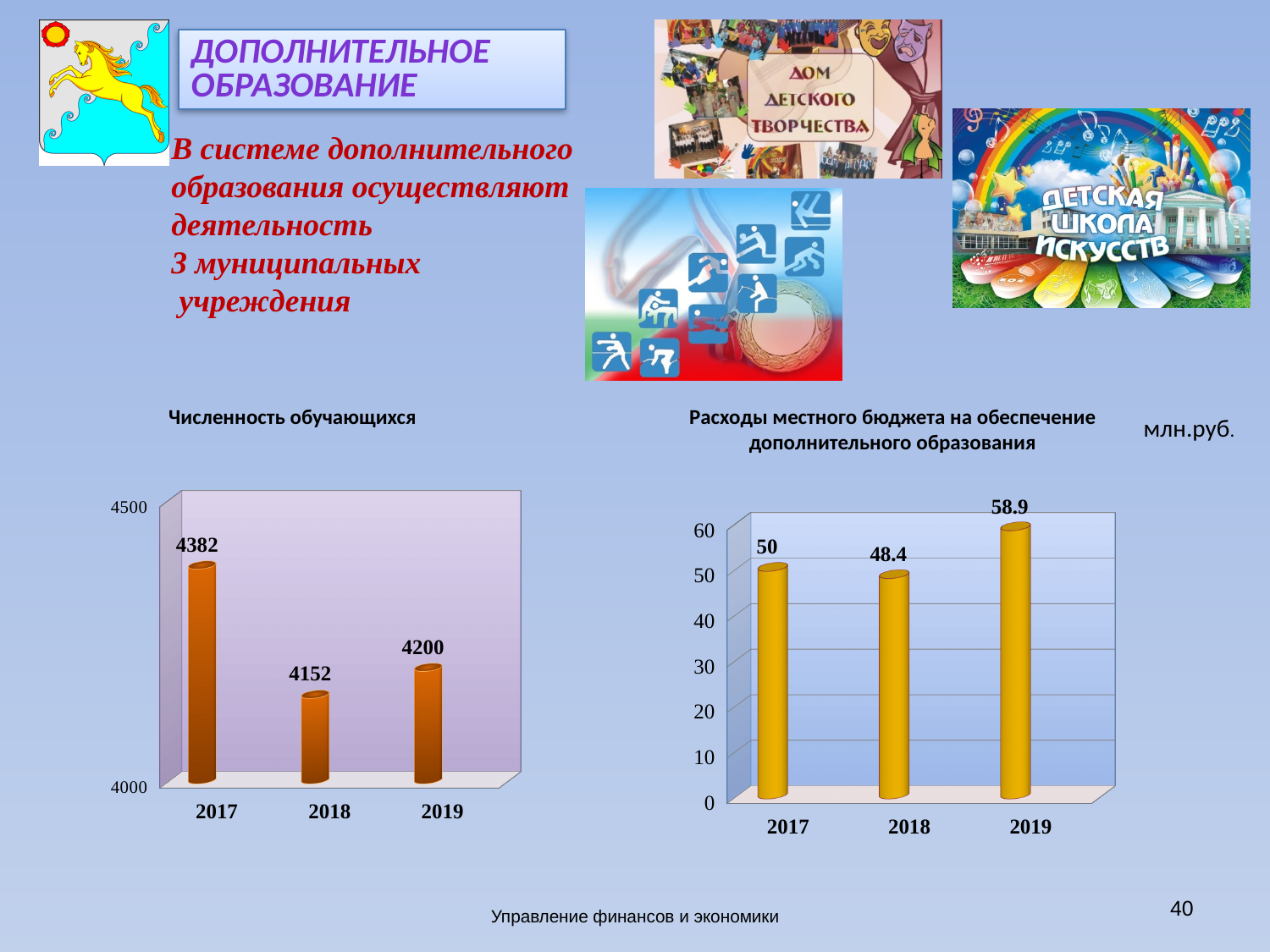
In the 'Расходы местного бюджета на обеспечение дополнительного образования' chart, what is the value for 2018? 48.4 In the 'Численность обучающихся' chart, what is the difference between the 2017 and 2019 values? 182 In the 'Расходы местного бюджета на обеспечение дополнительного образования' chart, which year has the highest value? 2019 What unit is indicated next to the title of the 'Расходы местного бюджета на обеспечение дополнительного образования' chart? млн.руб. In the 'Численность обучающихся' chart, what is the value for 2017? 4382 In the 'Расходы местного бюджета на обеспечение дополнительного образования' chart, is the value for 2017 larger than the value for 2018? Yes In the 'Численность обучающихся' chart, what is the value for 2018? 4152 What type of chart is the 'Расходы местного бюджета на обеспечение дополнительного образования' chart? Bar chart In the 'Расходы местного бюджета на обеспечение дополнительного образования' chart, what is the value for 2019? 58.9 In the 'Численность обучающихся' chart, which year has the lowest value? 2018 In the 'Расходы местного бюджета на обеспечение дополнительного образования' chart, what is the difference between the 2019 and 2017 values? 8.9 In the 'Численность обучающихся' chart, how many years are shown? 3